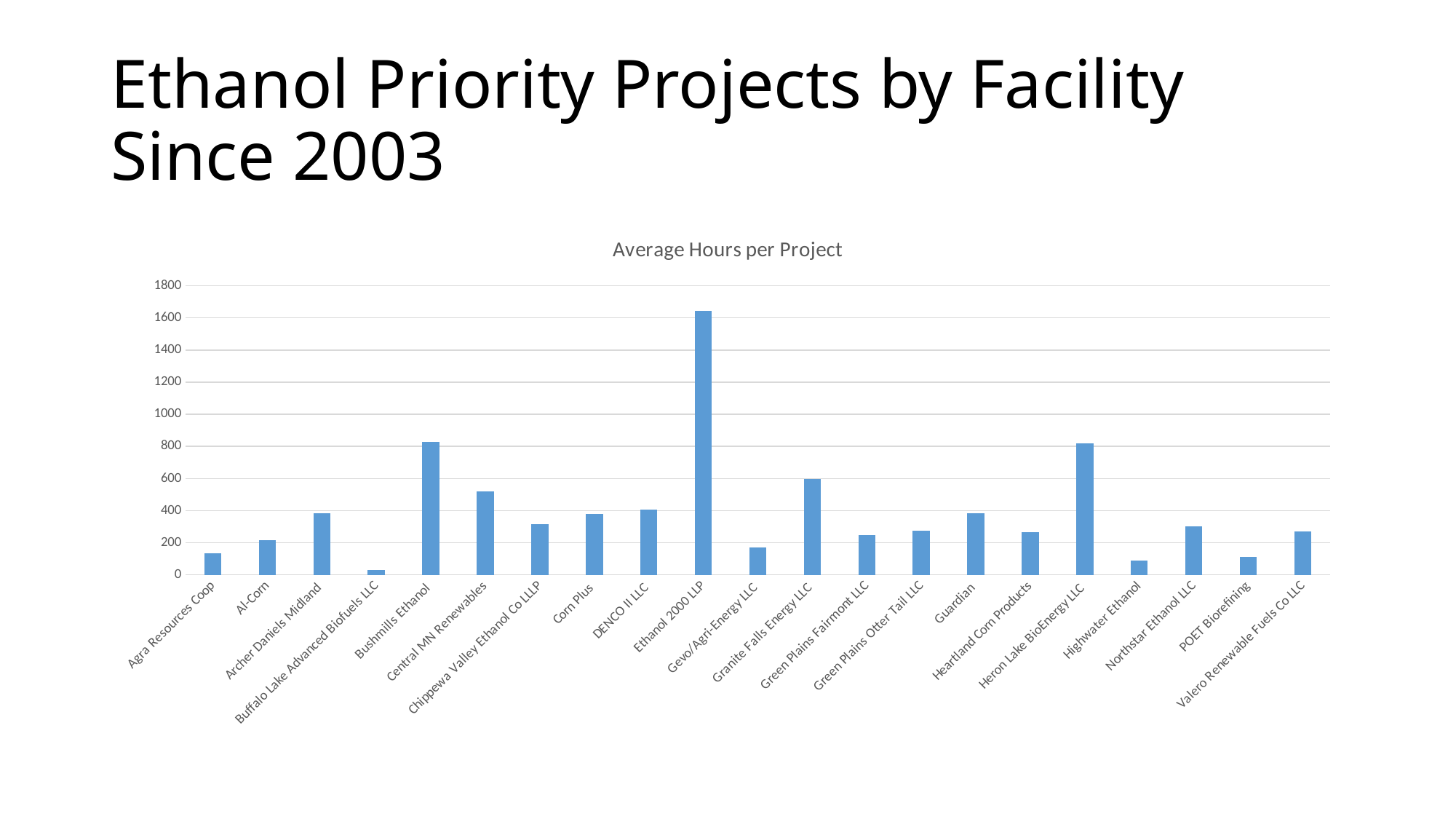
Is the value for Ethanol 2000 LLP greater or less than 1600? greater Which facility has the highest average hours per project? Ethanol 2000 LLP What kind of chart is shown on the slide? bar chart How many facilities are shown on the x axis of the chart? 21 Is the value for Central MN Renewables greater or less than 400? greater Which facility has the lowest average hours per project? Buffalo Lake Advanced Biofuels LLC Is the value for Bushmills Ethanol greater or less than 800? greater Which has a higher average hours per project, Granite Falls Energy LLC or Corn Plus? Granite Falls Energy LLC Which has a higher average hours per project, Ethanol 2000 LLP or Bushmills Ethanol? Ethanol 2000 LLP What is the title of the chart? Average Hours per Project